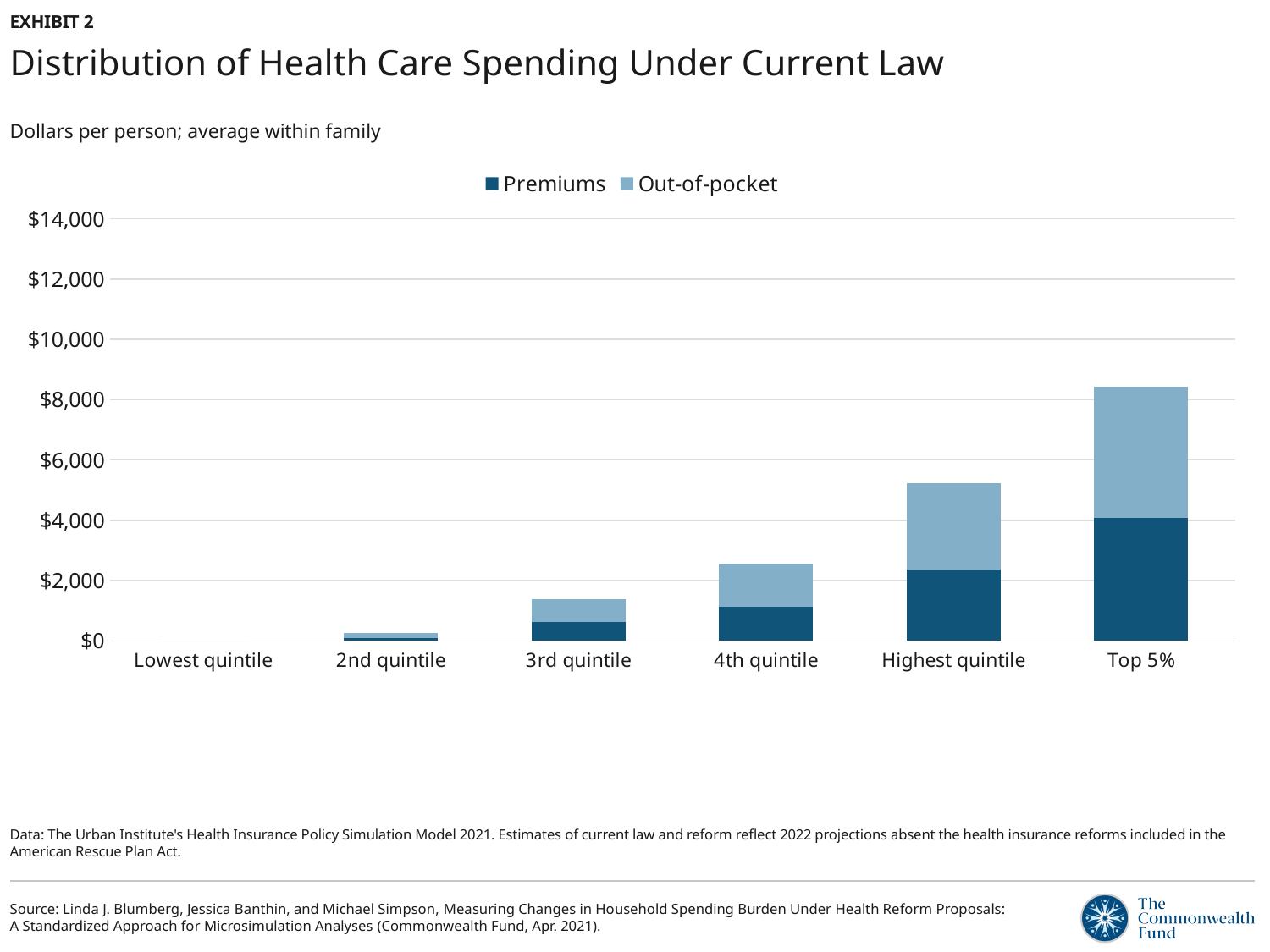
Which is larger, the total spending for Highest quintile or for 4th quintile? Highest quintile Is the total spending for 3rd quintile greater or less than $2,000? less Is the total spending for 4th quintile greater or less than $2,000? greater What kind of chart is shown on the slide? Stacked bar chart How many series does the legend list? 2 Which category has the highest total spending? Top 5% Is the total spending for Highest quintile greater or less than $6,000? less Do total spending values rise or fall moving from Lowest quintile to Top 5% along the x axis? rise How many categories are shown on the x axis? 6 Which category has the lowest total spending? Lowest quintile